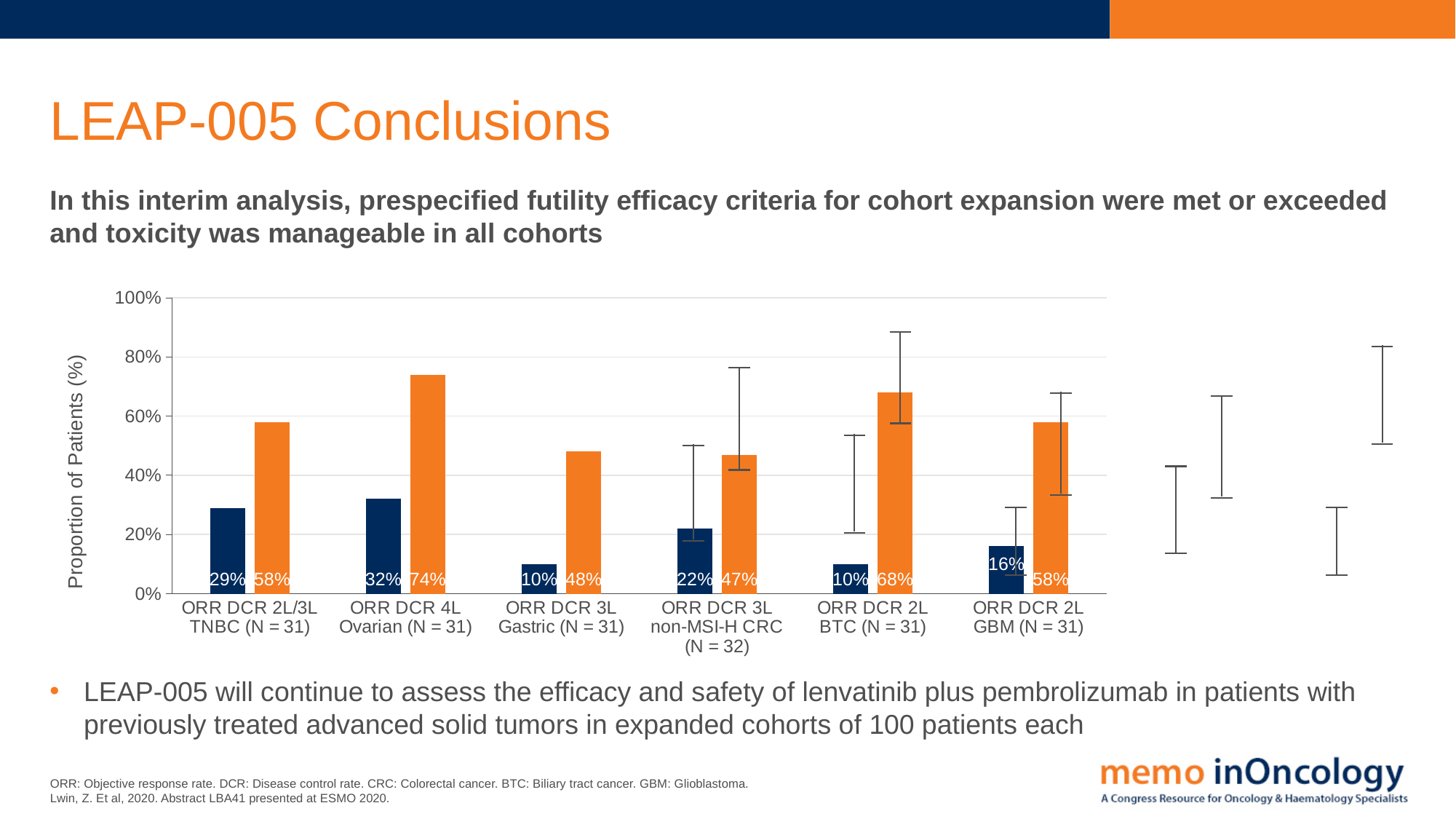
How many cohorts are shown on the x axis of the chart? 6 What kind of chart is shown on the slide? Bar chart What is the difference between the DCR and ORR for the Gastric (N = 31) cohort? 38% Which is larger, the DCR for the non-MSI-H CRC cohort or the DCR for the BTC cohort? DCR for BTC What is the ORR for the GBM (N = 31) cohort? 16% Which cohort has the highest ORR? Ovarian (N = 31) What is the ORR for the TNBC (N = 31) cohort? 29% What is the DCR for the BTC (N = 31) cohort? 68% Is the DCR for the Ovarian (N = 31) cohort greater or less than 60%? greater What is the label of the y axis of the chart? Proportion of Patients (%) Which cohort has the highest DCR? Ovarian (N = 31) What is the DCR for the Ovarian (N = 31) cohort? 74%